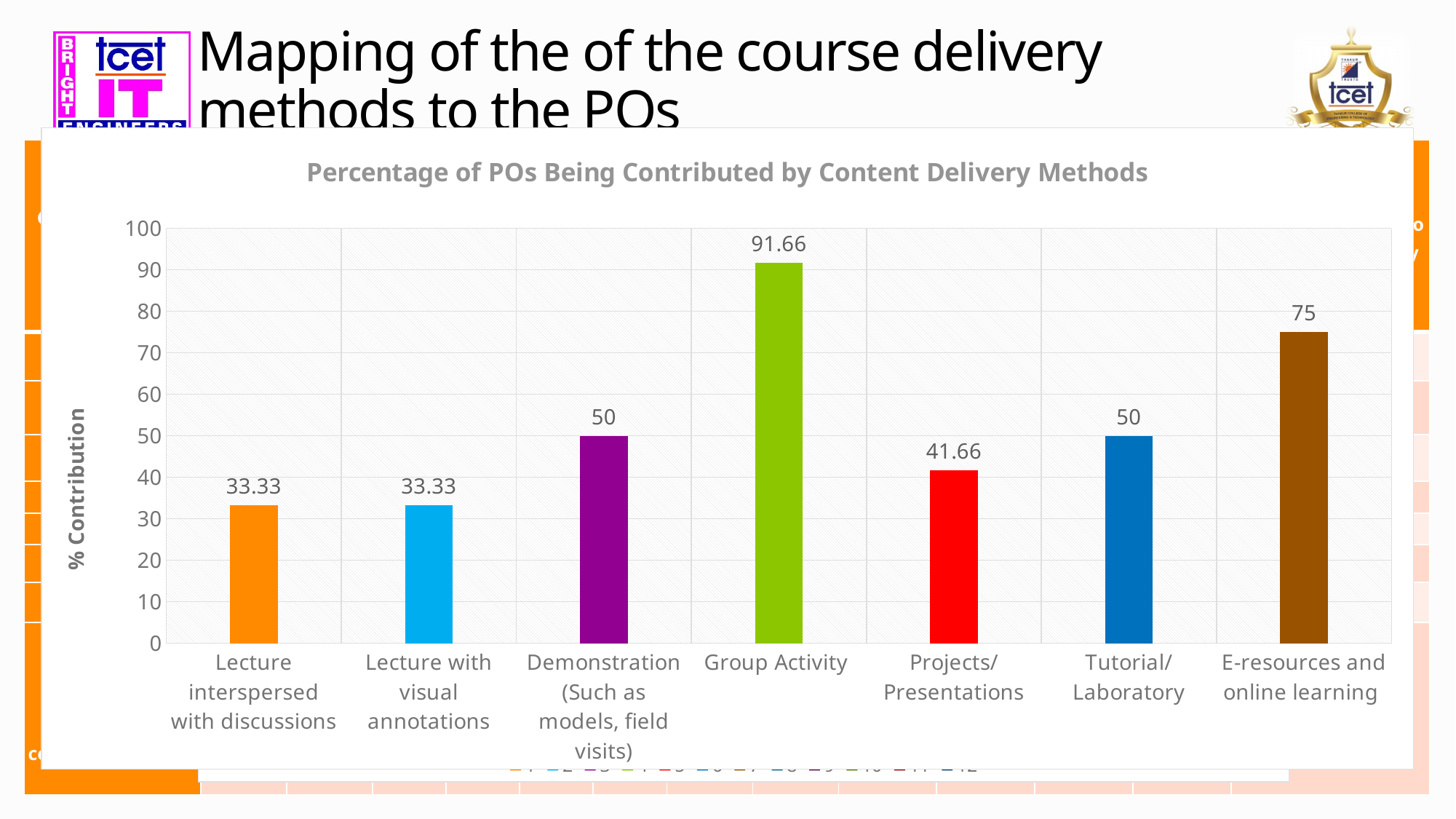
What is the value for E-resources and online learning? 75 Is the value for E-resources and online learning greater or less than 70? greater Which content delivery method has the highest % Contribution? Group Activity How many content delivery methods are shown on the x axis? 7 What is the value for Lecture with visual annotations? 33.33 What kind of chart is shown on the slide? Bar chart What is the value for Projects/ Presentations? 41.66 What is the difference between the values for Demonstration (Such as models, field visits) and Projects/ Presentations? 8.34 Which is larger, the value for Tutorial/ Laboratory or the value for Projects/ Presentations? Tutorial/ Laboratory What is the difference between the values for Group Activity and E-resources and online learning? 16.66 What is the title of the chart? Percentage of POs Being Contributed by Content Delivery Methods What is the value for Group Activity? 91.66